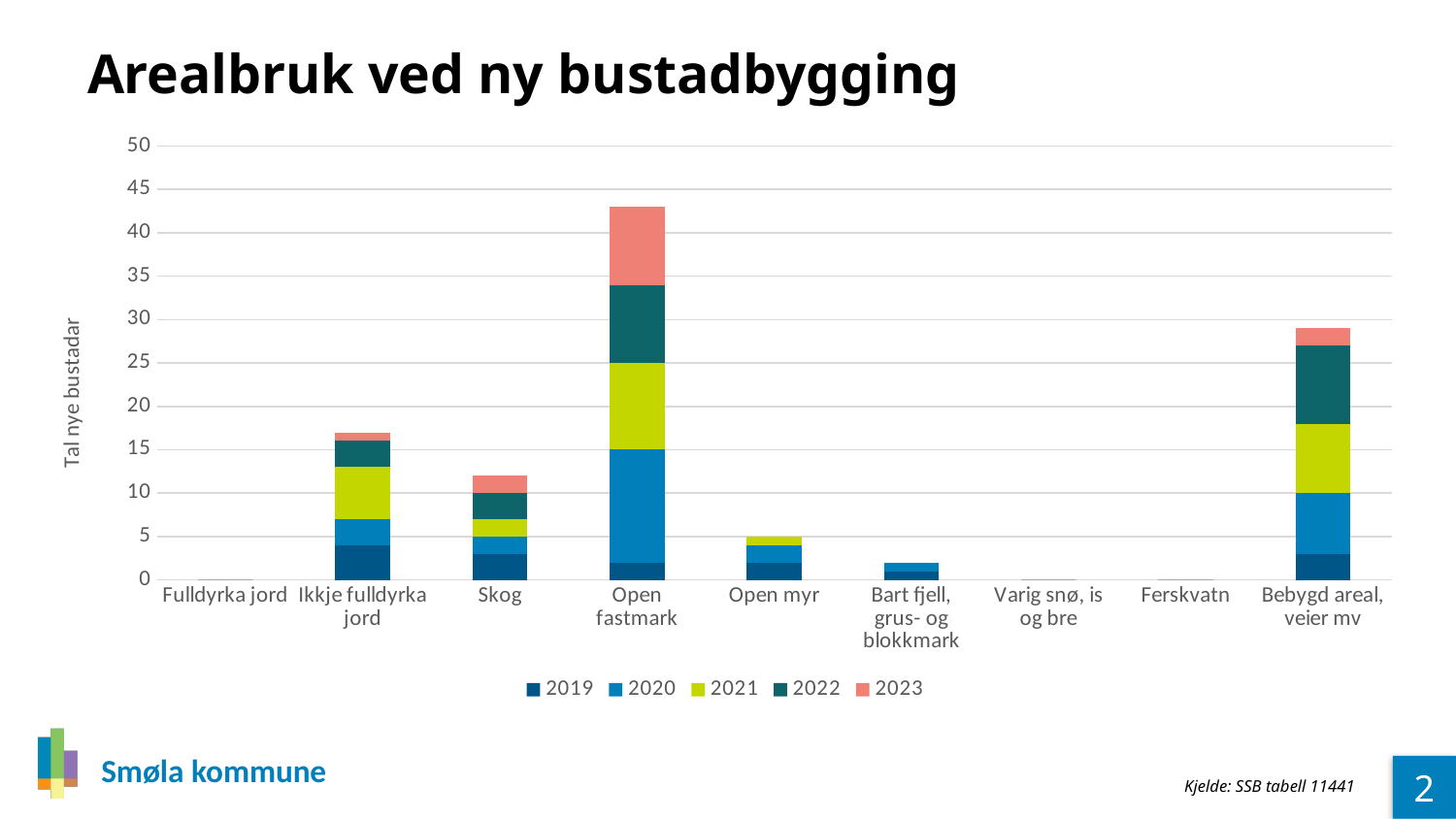
Which has a larger total, Bebygd areal, veier mv or Ikkje fulldyrka jord? Bebygd areal, veier mv Is the total value for Ikkje fulldyrka jord greater or less than 15? greater Is the total value for Open fastmark greater or less than 40? greater What is the label of the y axis? Tal nye bustadar Is the total value for Bebygd areal, veier mv greater or less than 25? greater What is the title of the chart? Arealbruk ved ny bustadbygging Which category has the highest total stacked bar? Open fastmark How many series does the legend list? 5 How many categories are shown on the x axis? 9 What kind of chart is shown on the slide? stacked bar chart Which has a larger total, Skog or Open myr? Skog